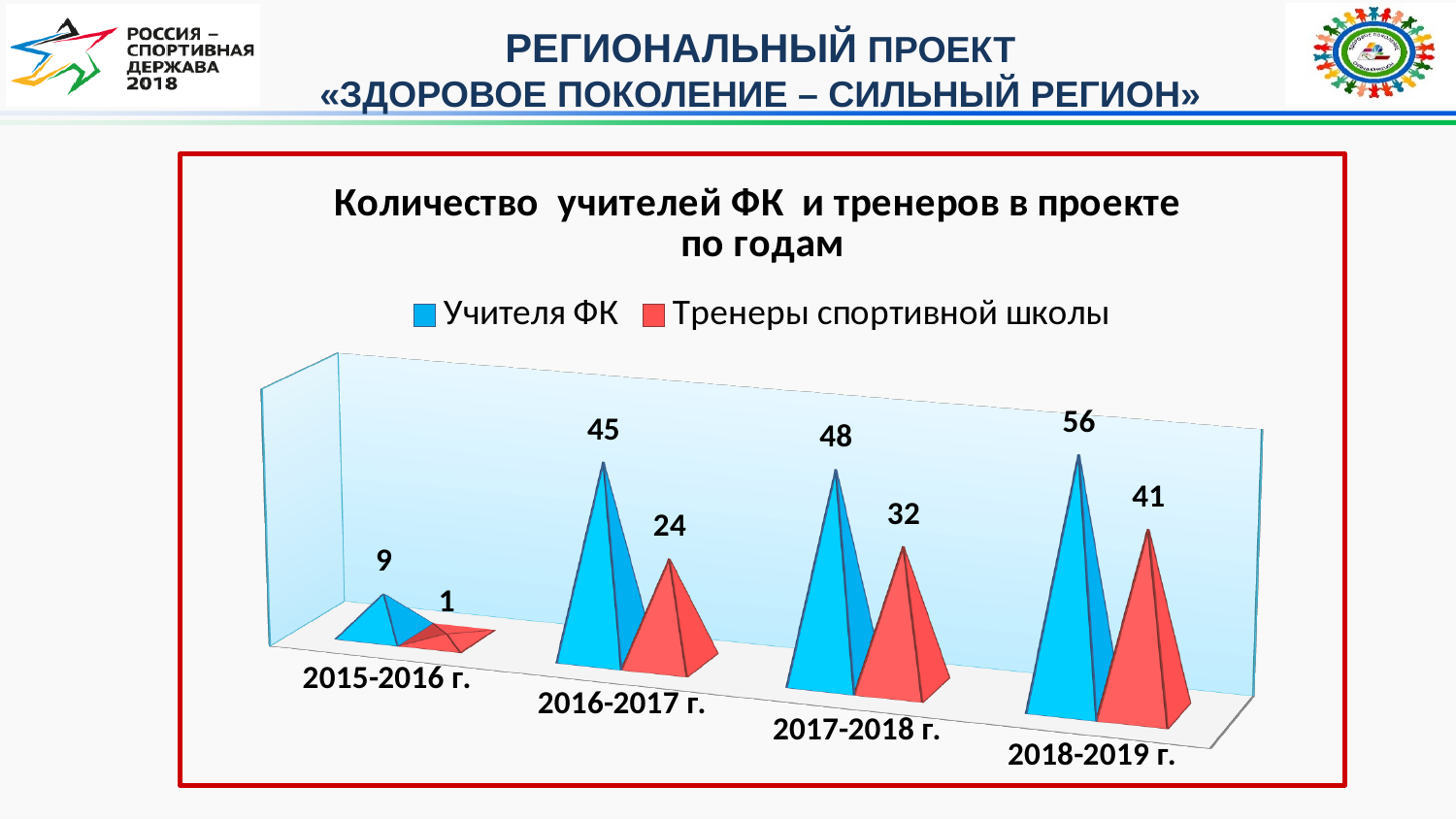
What is the difference between Учителя ФК and Тренеры спортивной школы in 2018-2019 г.? 15 What colour represents Учителя ФК in the legend? blue How many year categories are shown on the x axis? 4 What kind of chart is shown? bar chart In which year is the value for Учителя ФК highest? 2018-2019 г. What is the value for Тренеры спортивной школы in 2017-2018 г.? 32 What is the value for Учителя ФК in 2016-2017 г.? 45 How many series does the legend list? 2 Do the values for Тренеры спортивной школы rise or fall from 2015-2016 г. to 2018-2019 г.? rise Which is larger in 2017-2018 г.: Учителя ФК or Тренеры спортивной школы? Учителя ФК In which year is the value for Тренеры спортивной школы lowest? 2015-2016 г. What is the value for Тренеры спортивной школы in 2015-2016 г.? 1